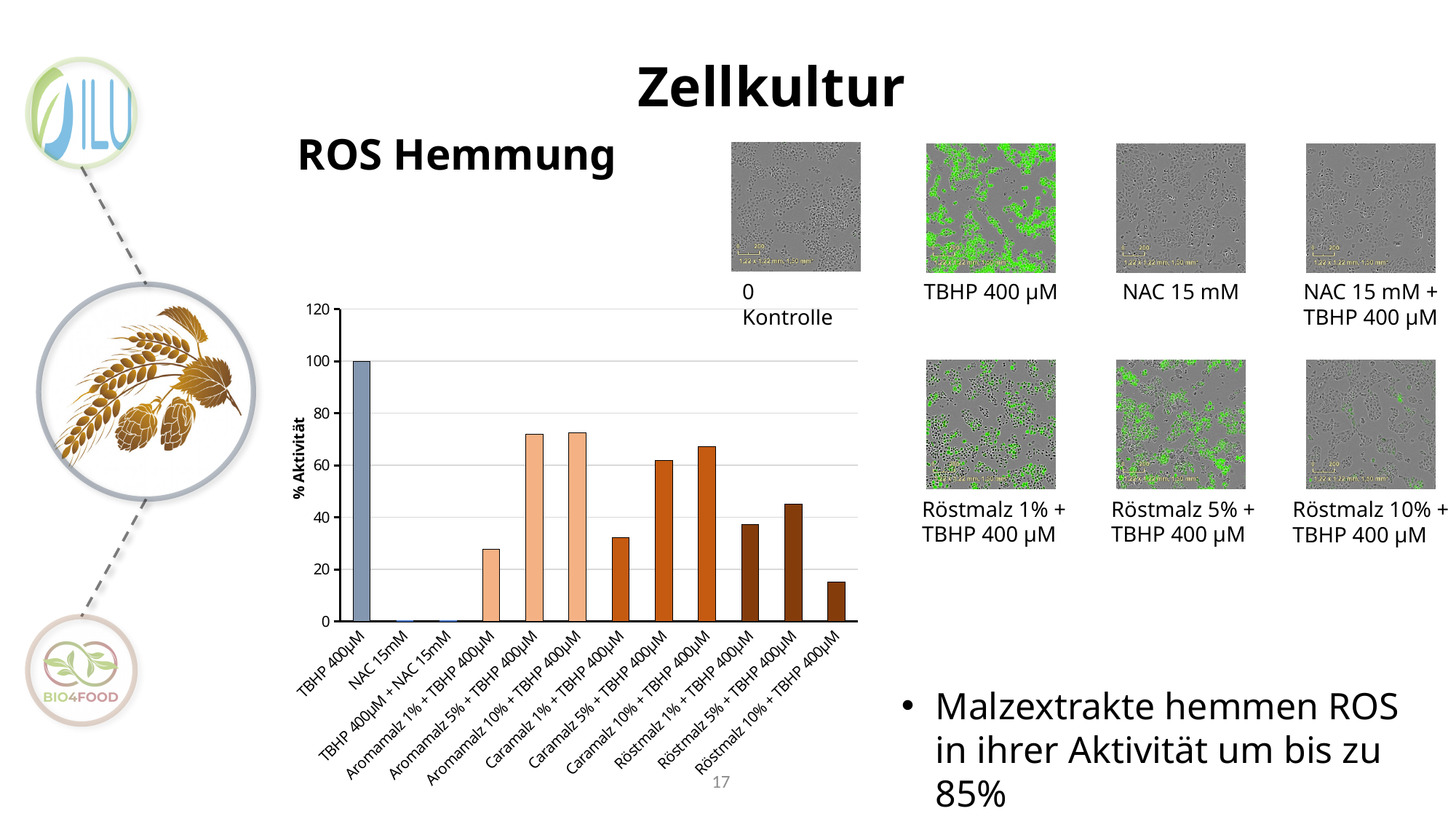
Is the value for Caramalz 5% + TBHP 400µM greater or less than 40? greater What is the label of the y axis of the bar chart? % Aktivität What kind of chart is shown on the slide? bar chart What is the heading shown above the bar chart? ROS Hemmung What is the % Aktivität value for TBHP 400µM? 100 How many categories are plotted on the x axis of the bar chart? 12 Is the value for Röstmalz 10% + TBHP 400µM greater or less than 20? less Is the value for Aromamalz 1% + TBHP 400µM greater or less than 40? less Which category has the highest % Aktivität in the bar chart? TBHP 400µM Which has a higher % Aktivität: Aromamalz 5% + TBHP 400µM or Caramalz 1% + TBHP 400µM? Aromamalz 5% + TBHP 400µM Which has a higher % Aktivität: Röstmalz 5% + TBHP 400µM or Röstmalz 10% + TBHP 400µM? Röstmalz 5% + TBHP 400µM